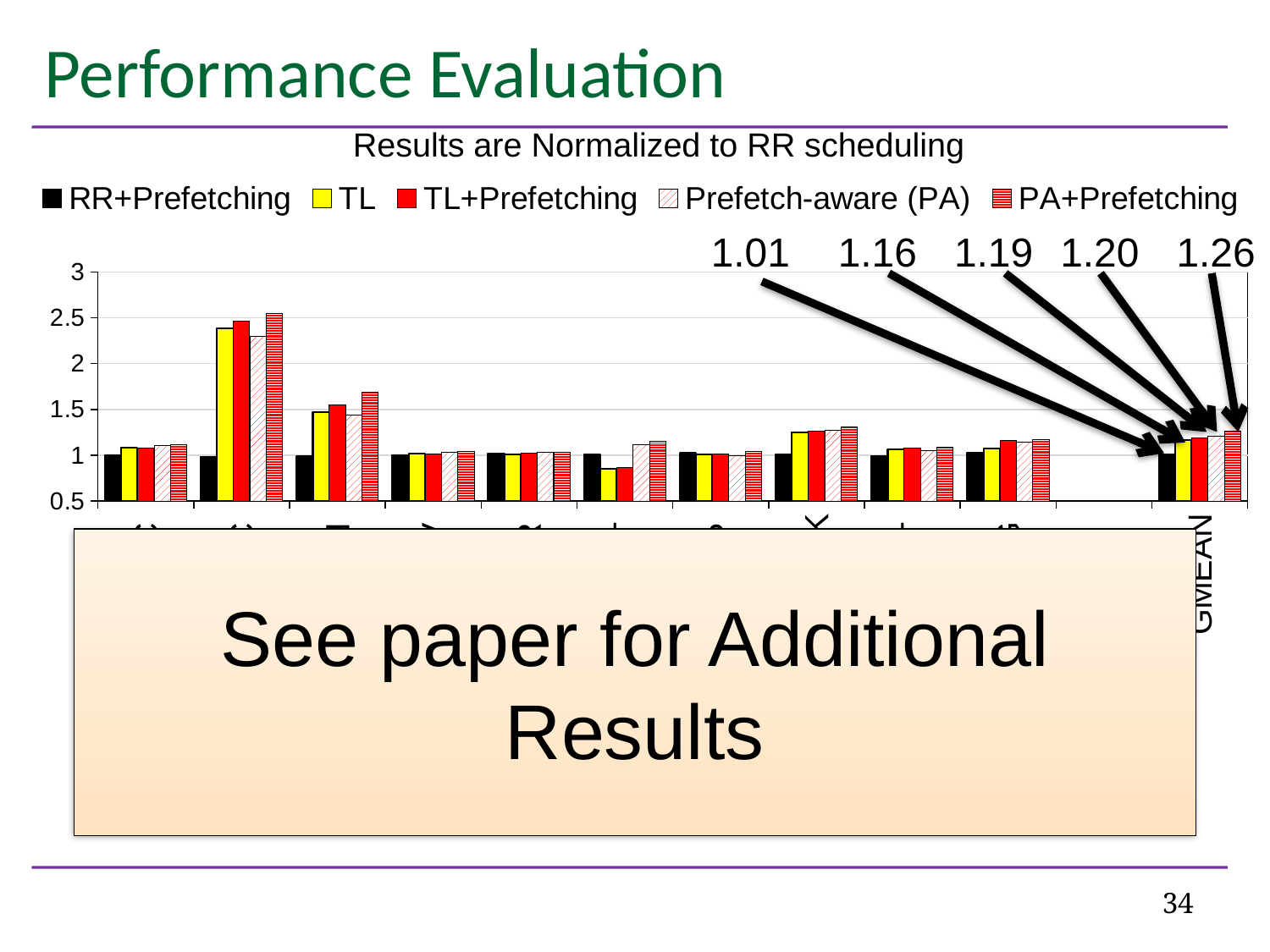
At GMEAN, which is larger: TL or TL+Prefetching? TL+Prefetching What is the difference between the GMEAN values of PA+Prefetching and RR+Prefetching? 0.25 What is the title of the chart? Results are Normalized to RR scheduling What is the GMEAN value for Prefetch-aware (PA)? 1.20 Which series has the lowest GMEAN value? RR+Prefetching What is the GMEAN value for TL+Prefetching? 1.19 What kind of chart is shown on the slide? bar chart Which series has the highest GMEAN value? PA+Prefetching What is the GMEAN value for RR+Prefetching? 1.01 How many series does the legend list? 5 What is the GMEAN value for PA+Prefetching? 1.26 What is the GMEAN value for TL? 1.16